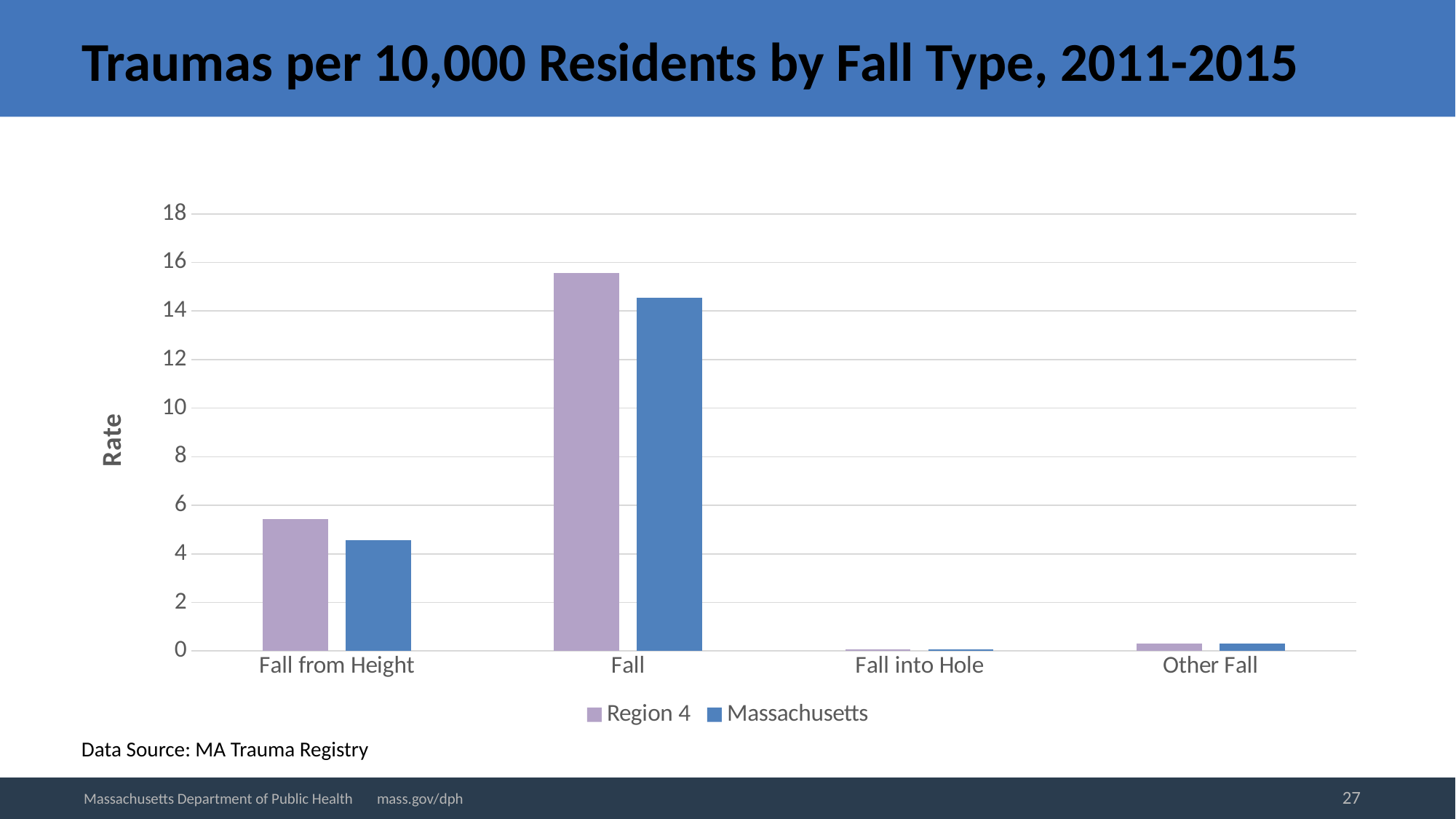
Which fall type has the highest rate for Massachusetts? Fall How many fall type categories are shown on the x axis? 4 Which fall type has the highest rate for Region 4? Fall What is the label on the y axis? Rate For Fall from Height, which is larger: the Region 4 rate or the Massachusetts rate? Region 4 What is the title of the chart? Traumas per 10,000 Residents by Fall Type, 2011-2015 Is the Region 4 rate for Fall greater or less than 14? greater How many series does the legend list? 2 Is the Massachusetts rate for Fall from Height greater or less than 6? less What kind of chart is shown on the slide? bar chart Is the Region 4 rate for Fall from Height greater or less than 4? greater For Fall, which is larger: the Region 4 rate or the Massachusetts rate? Region 4